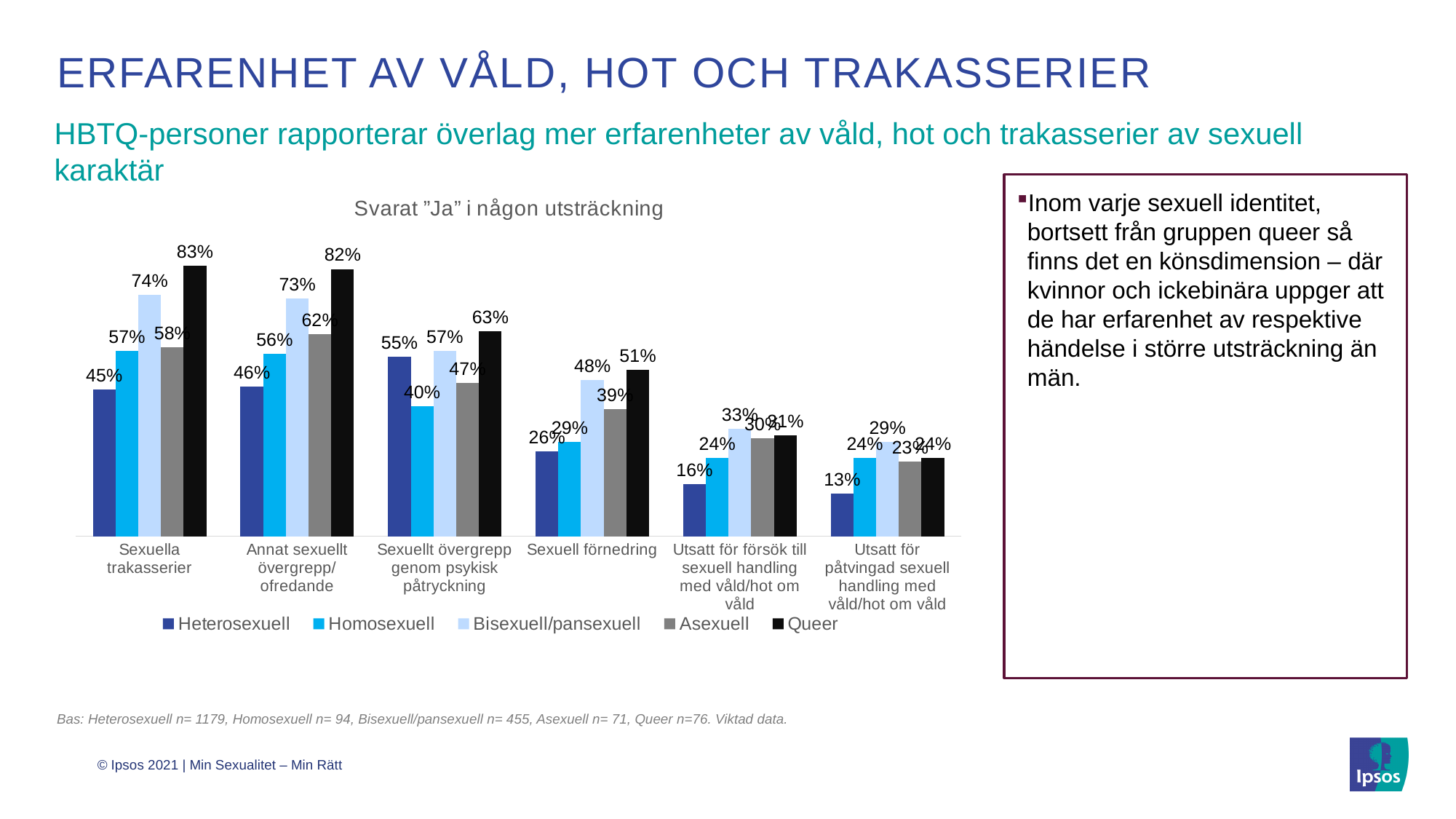
How many series does the legend list? 5 Which series has the highest value in the category Sexuellt övergrepp genom psykisk påtryckning? Queer Which series is shown in black in the chart? Queer What is the title of the chart? Svarat "Ja" i någon utsträckning What type of chart is shown on the slide? bar chart Which series has the lowest value in the category Utsatt för påtvingad sexuell handling med våld/hot om våld? Heterosexuell What is the value for Bisexuell/pansexuell in the category Annat sexuellt övergrepp/ofredande? 73% How many categories are shown on the x axis? 6 In the category Sexuellt övergrepp genom psykisk påtryckning, which is larger: the Heterosexuell value or the Homosexuell value? Heterosexuell What is the value for Heterosexuell in the category Sexuell förnedring? 26% What is the value for Queer in the category Sexuella trakasserier? 83% What is the difference between the Queer and Heterosexuell values in the category Sexuella trakasserier? 38 percentage points